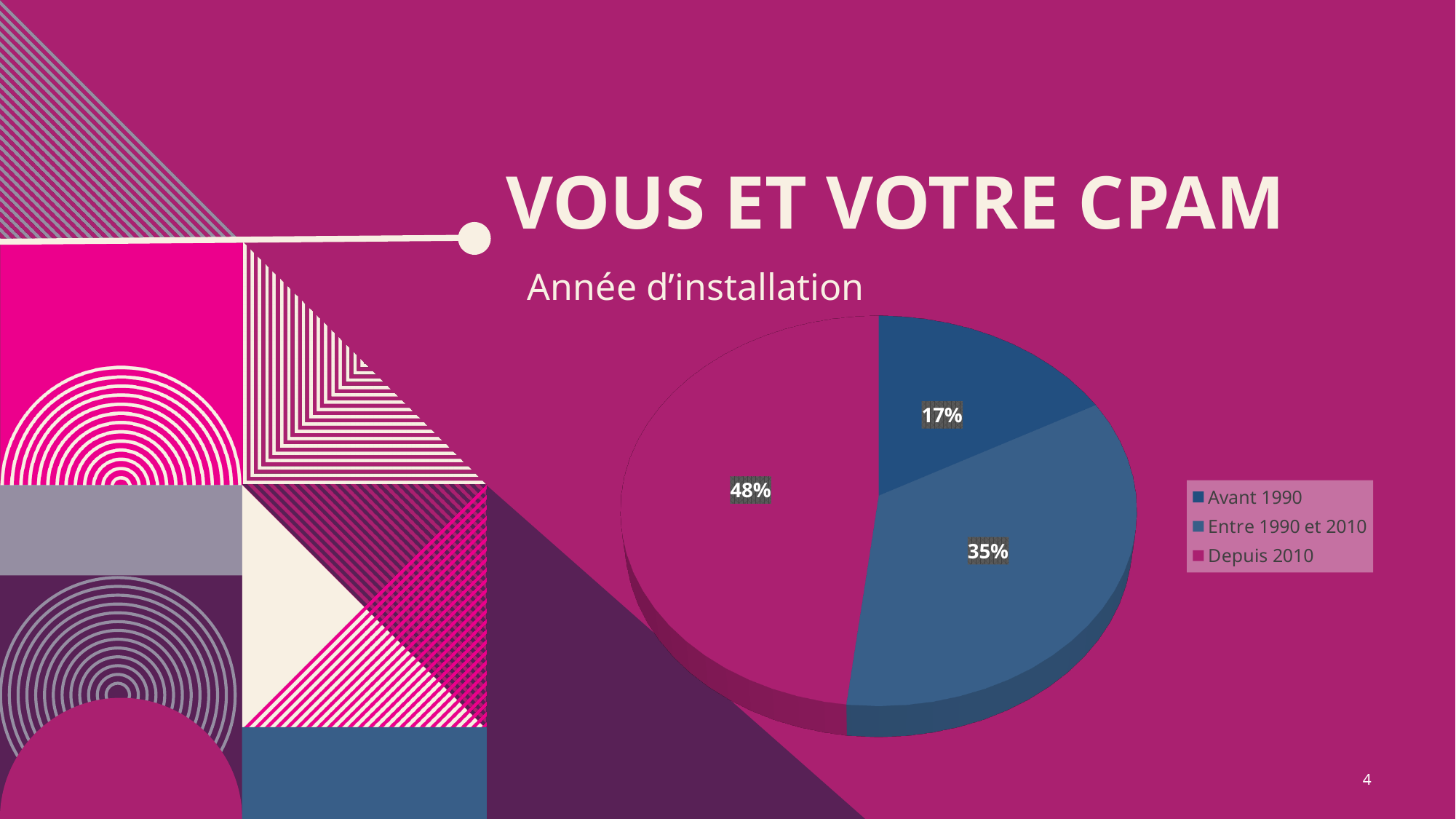
What percentage of the pie chart corresponds to 'Depuis 2010'? 48% Which is larger: the share for 'Entre 1990 et 2010' or the share for 'Avant 1990'? Entre 1990 et 2010 Which category has the largest share of the pie chart? Depuis 2010 What is the difference in percentage points between 'Entre 1990 et 2010' and 'Avant 1990'? 18 What is the difference in percentage points between 'Depuis 2010' and 'Avant 1990'? 31 What is the title of the chart? Année d'installation Which legend entry is shown in the darkest blue colour? Avant 1990 What kind of chart is shown on the slide? Pie chart How many categories does the pie chart show? 3 What percentage of the pie chart corresponds to 'Entre 1990 et 2010'? 35% Which category has the smallest share of the pie chart? Avant 1990 What percentage of the pie chart corresponds to 'Avant 1990'? 17%